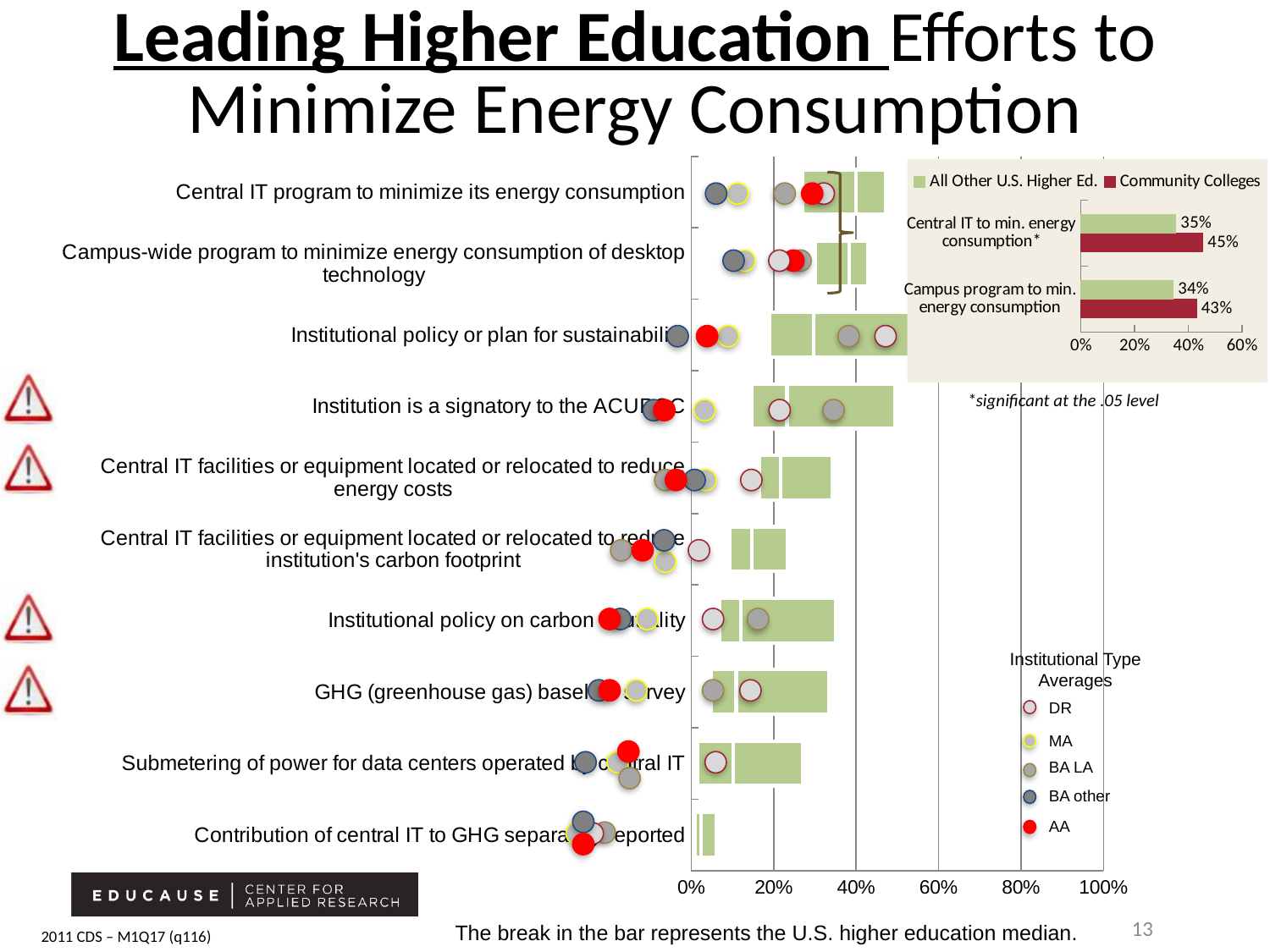
How many categories (rows) are shown in the main chart on the left? 10 According to the note under the main chart, what does the break in each bar represent? The U.S. higher education median What kind of chart is the inset chart at the top right? Bar chart How many institutional types does the 'Institutional Type Averages' legend of the main chart list? 5 In the main chart, is the bar for 'Contribution of central IT to GHG separately reported' greater or less than 20%? less In the inset bar chart at the top right, which group has the larger value for 'Campus program to min. energy consumption', Community Colleges or All Other U.S. Higher Ed.? Community Colleges In the inset bar chart at the top right, what is the value for All Other U.S. Higher Ed. for 'Central IT to min. energy consumption'? 35% In the inset bar chart at the top right, what is the difference between Community Colleges and All Other U.S. Higher Ed. for 'Central IT to min. energy consumption'? 10 percentage points In the inset bar chart at the top right, which bar has the highest value? Community Colleges, Central IT to min. energy consumption (45%) How many series does the legend of the inset bar chart at the top right list? 2 In the inset bar chart at the top right, what is the value for Community Colleges for 'Central IT to min. energy consumption'? 45% In the inset bar chart at the top right, what is the value for All Other U.S. Higher Ed. for 'Campus program to min. energy consumption'? 34%